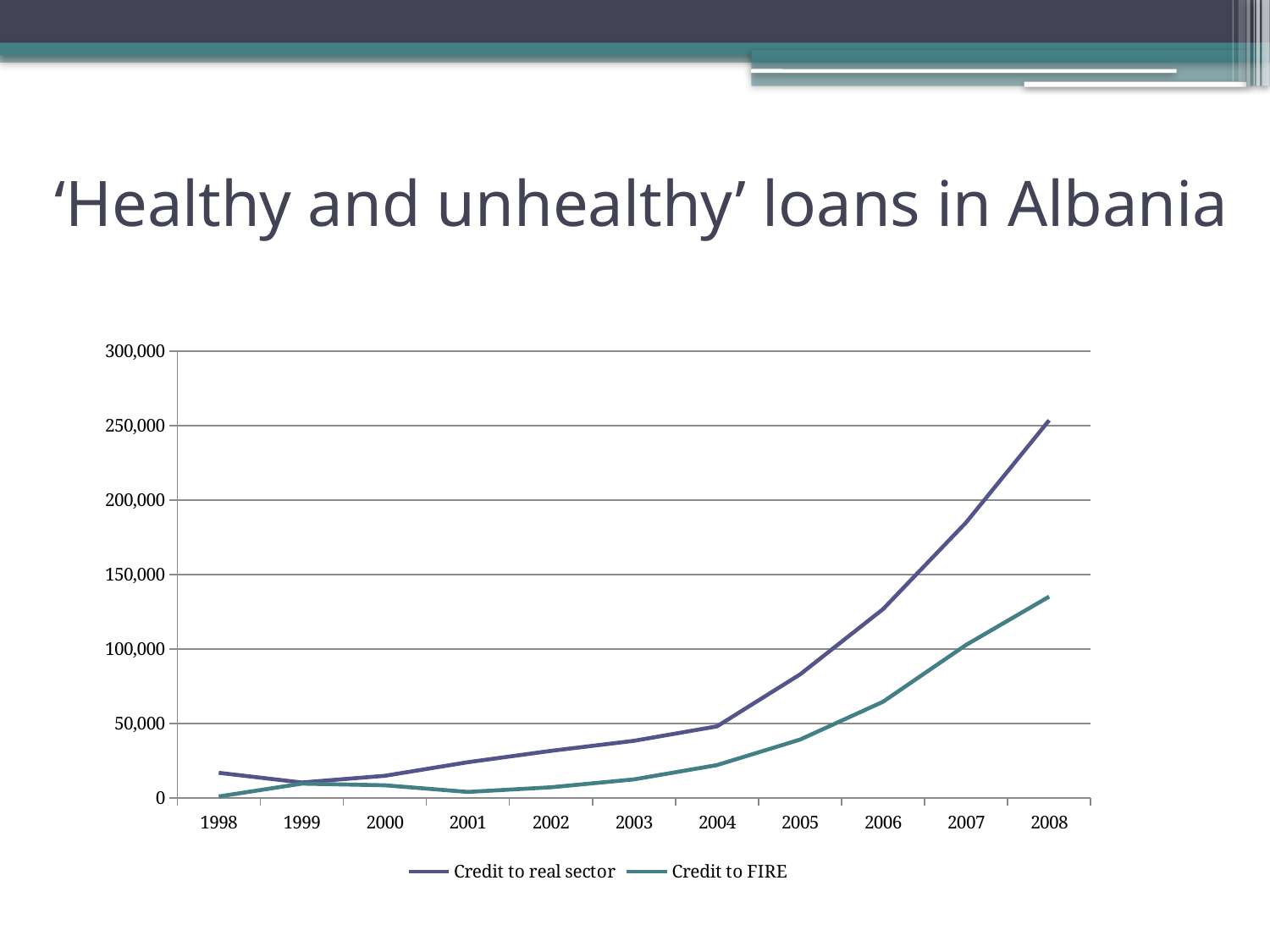
Does Credit to FIRE generally rise or fall from 2001 to 2008? rise What is the title of the slide? 'Healthy and unhealthy' loans in Albania Which series has the larger value in 2008, Credit to real sector or Credit to FIRE? Credit to real sector Is the value for Credit to real sector in 2008 greater or less than 200,000? greater In which year is Credit to FIRE at its lowest value? 1998 Is the value for Credit to real sector in 2006 greater or less than 100,000? greater How many series does the legend list? 2 In which year does Credit to real sector reach its highest value? 2008 How many years are plotted along the x axis? 11 What are the two series named in the legend? Credit to real sector; Credit to FIRE What kind of chart is shown on the slide? line chart Is the value for Credit to FIRE in 2008 greater or less than 150,000? less